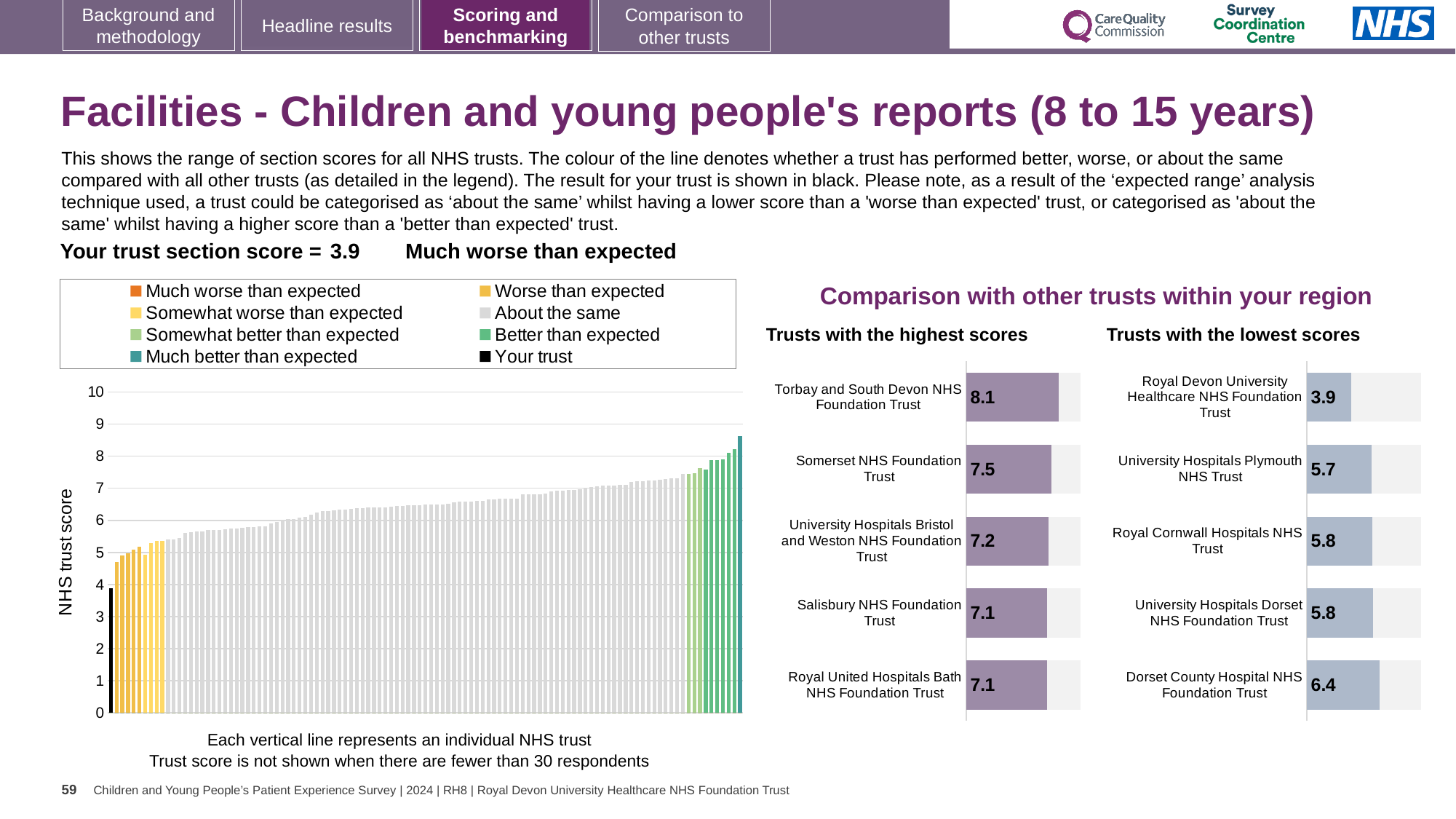
In the 'Trusts with the lowest scores' chart, which trust has the lowest score? Royal Devon University Healthcare NHS Foundation Trust In the 'Trusts with the lowest scores' chart, which has the larger score: University Hospitals Plymouth NHS Trust or Dorset County Hospital NHS Foundation Trust? Dorset County Hospital NHS Foundation Trust What kind of chart is the 'Trusts with the lowest scores' chart? bar chart In the 'Trusts with the highest scores' chart, which trust has the highest score? Torbay and South Devon NHS Foundation Trust In the large chart on the left showing the range of section scores, is the value of the tallest bar greater or less than 8? greater In the large chart on the left showing the range of section scores, do the bar values rise or fall from left to right? rise How many entries does the legend of the large chart on the left list? 8 In the 'Trusts with the highest scores' chart, what is the score for Torbay and South Devon NHS Foundation Trust? 8.1 In the 'Trusts with the lowest scores' chart, what is the score for University Hospitals Plymouth NHS Trust? 5.7 In the 'Trusts with the lowest scores' chart, what is the difference between the scores of Dorset County Hospital NHS Foundation Trust and Royal Devon University Healthcare NHS Foundation Trust? 2.5 In the 'Trusts with the highest scores' chart, what is the difference between the scores of Torbay and South Devon NHS Foundation Trust and Somerset NHS Foundation Trust? 0.6 How many trusts are shown in the 'Trusts with the highest scores' chart? 5